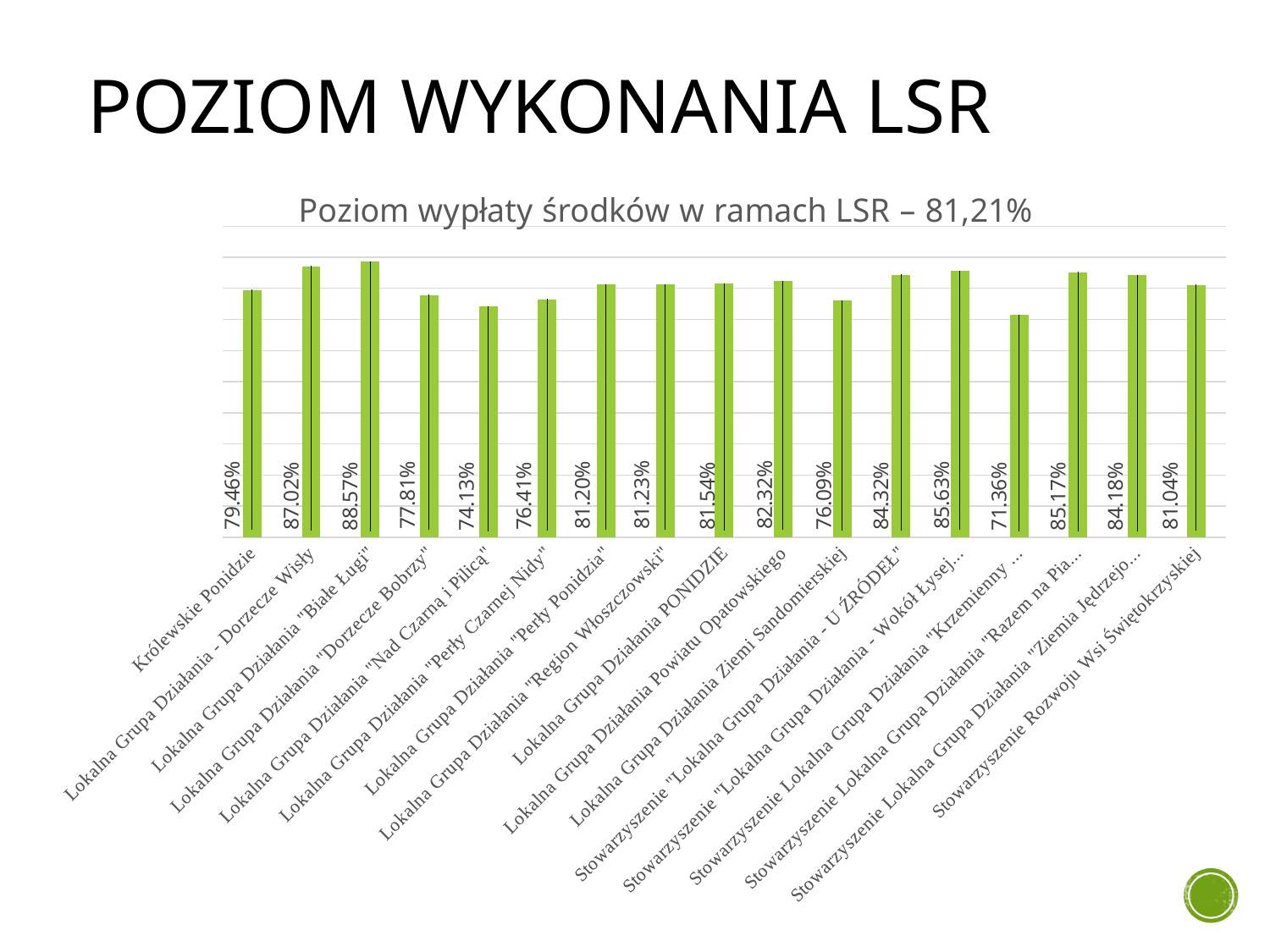
Which category has the lowest value? Stowarzyszenie Lokalna Grupa Działania "Krzemienny ..." Which category has the highest value? Lokalna Grupa Działania "Białe Ługi" What is the value for Lokalna Grupa Działania Ziemi Sandomierskiej? 76.09% What is the difference between the highest value (88,57%) and the lowest value (71,36%)? 17.21% What is the value for Stowarzyszenie Rozwoju Wsi Świętokrzyskiej? 81.04% What is the value for Lokalna Grupa Działania "Białe Ługi"? 88.57% What is the value for Lokalna Grupa Działania "Nad Czarną i Pilicą"? 74.13% Which is larger: the value for Lokalna Grupa Działania - Dorzecze Wisły or for Królewskie Ponidzie? Lokalna Grupa Działania - Dorzecze Wisły What kind of chart is shown on the slide? Bar chart What is the title of the chart? Poziom wypłaty środków w ramach LSR – 81,21% What is the value for Królewskie Ponidzie? 79.46% How many categories are shown in the chart? 17